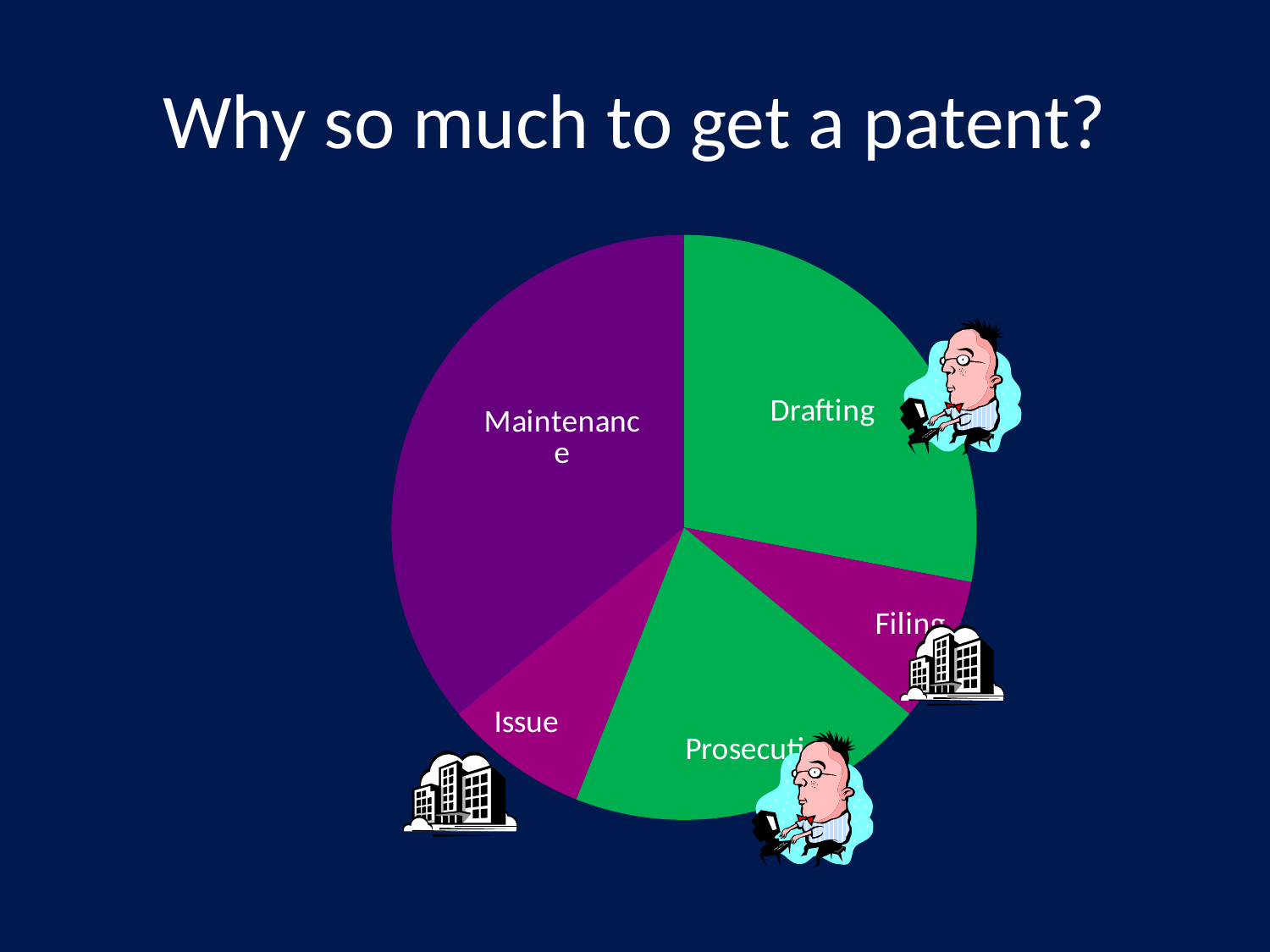
What colour is the Drafting slice of the pie chart? green Which slice is larger, Prosecution or Issue? Prosecution How many slices does the pie chart have? 5 Which slice is larger, Drafting or Prosecution? Drafting What is the title shown above the pie chart? Why so much to get a patent? Which slice is larger, Maintenance or Issue? Maintenance Which slice of the pie chart is the largest? Maintenance What kind of chart is shown on the slide? pie chart